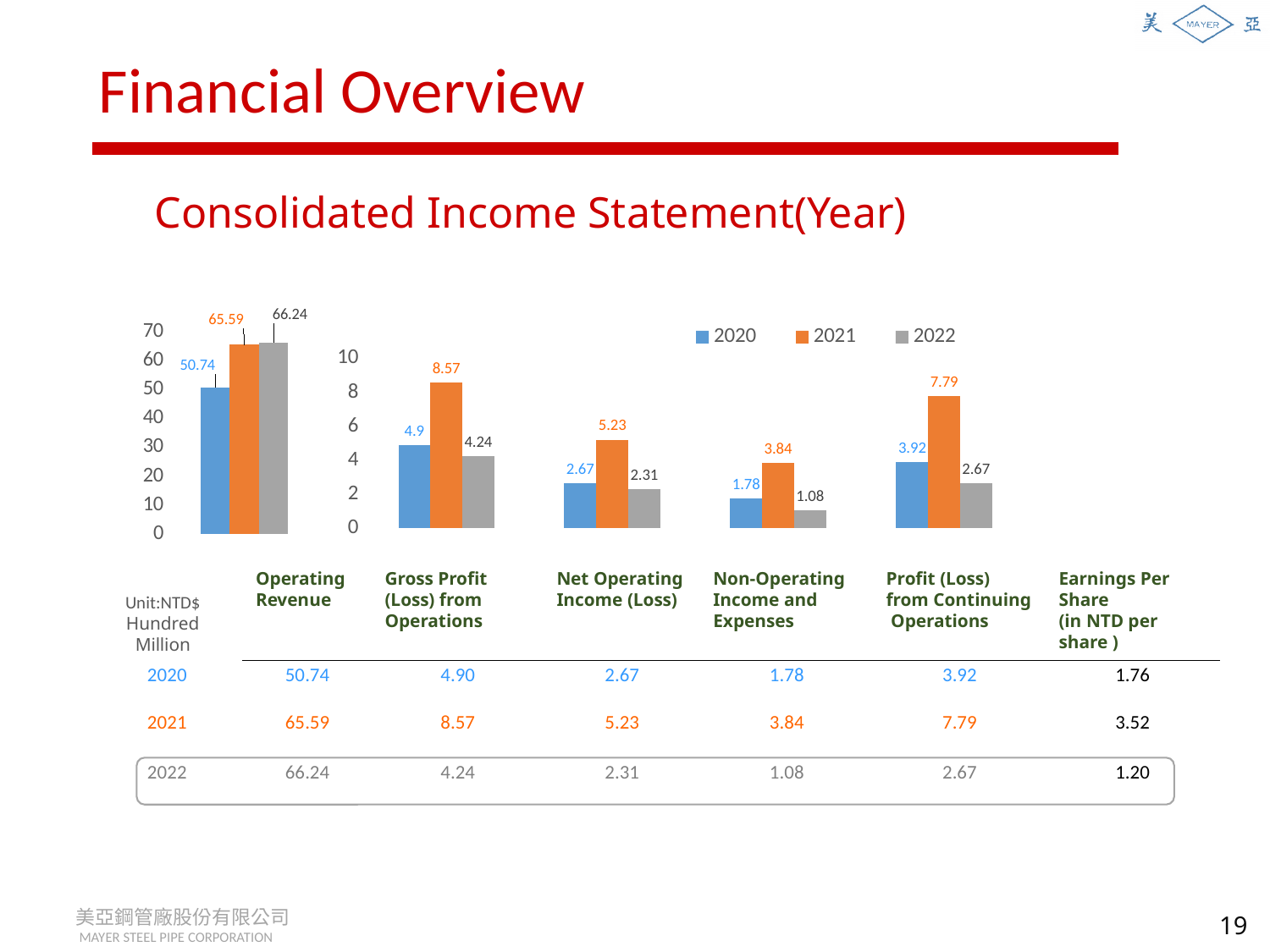
In the left chart (Operating Revenue), what is the difference between the 2022 and 2020 values? 15.50 In the right chart, what is the 2021 value for Gross Profit (Loss) from Operations? 8.57 In the right chart, what is the 2022 value for Non-Operating Income and Expenses? 1.08 How many categories are shown in the right chart? 4 In the left chart (Operating Revenue), what is the value for 2021? 65.59 In the right chart, which year has the lowest value for Profit (Loss) from Continuing Operations? 2022 In the right chart, do the values for Gross Profit (Loss) from Operations rise or fall from 2021 to 2022? Fall What kind of chart is the left chart? Bar chart How many series does the legend list? 3 In the left chart (Operating Revenue), which year has the highest value? 2022 In the right chart, what is the difference between the 2021 and 2020 values for Profit (Loss) from Continuing Operations? 3.87 In the right chart, is the 2020 value for Net Operating Income (Loss) larger or the 2022 value? 2020